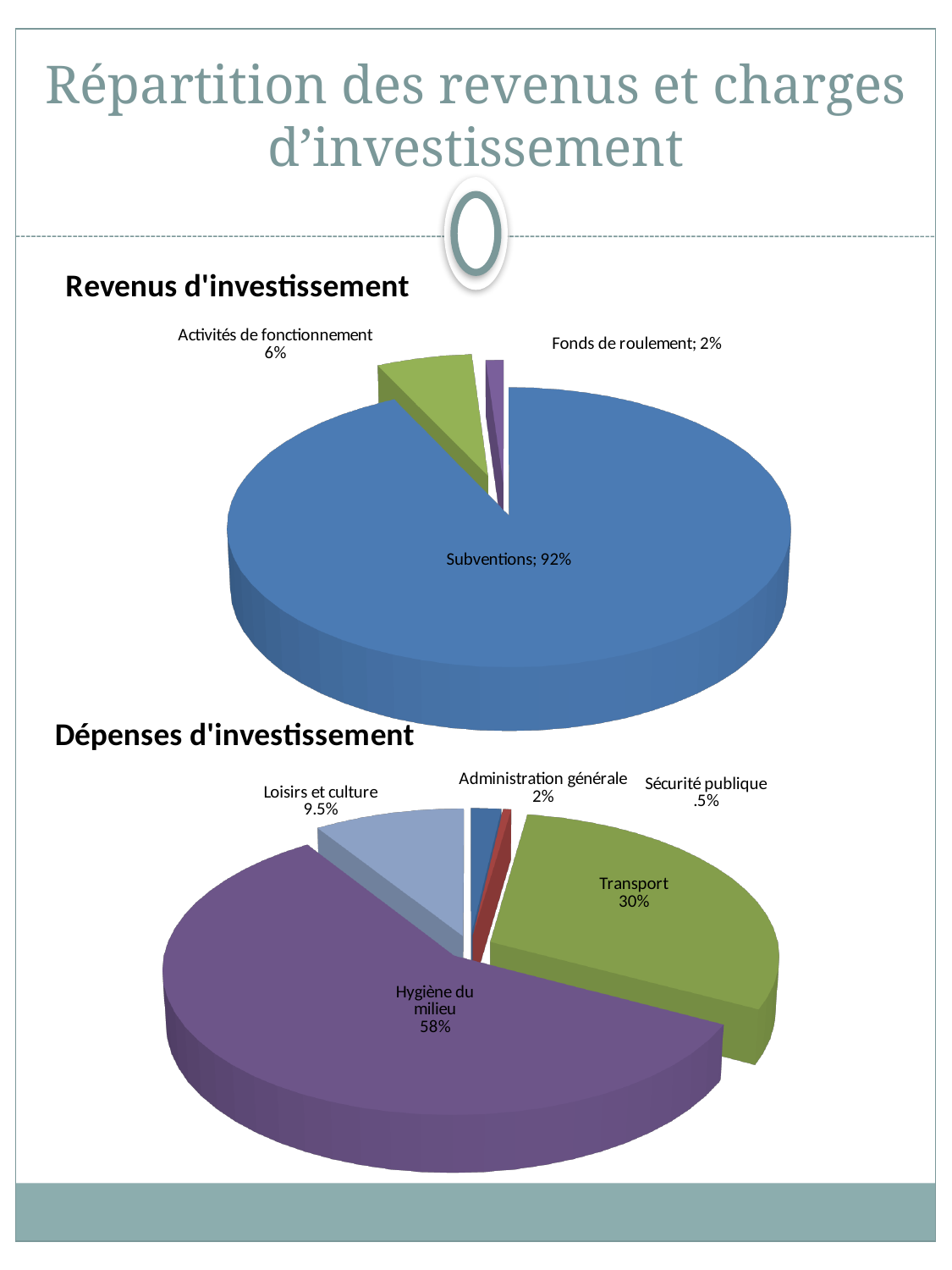
In the 'Revenus d'investissement' chart, what share does Subventions have? 92% In the 'Dépenses d'investissement' chart, what share does Loisirs et culture have? 9.5% In the 'Revenus d'investissement' chart, what is the difference between the Subventions share and the Activités de fonctionnement share? 86% In the 'Dépenses d'investissement' chart, which category has the smallest share? Sécurité publique In the 'Dépenses d'investissement' chart, what share does Transport have? 30% In the 'Revenus d'investissement' chart, how many slices does the pie have? 3 In the 'Dépenses d'investissement' chart, how many slices does the pie have? 5 What type of chart is the 'Revenus d'investissement' chart? Pie chart In the 'Dépenses d'investissement' chart, which is larger, Transport or Loisirs et culture? Transport In the 'Dépenses d'investissement' chart, which category has the largest share? Hygiène du milieu In the 'Revenus d'investissement' chart, which category has the smallest share? Fonds de roulement In the 'Revenus d'investissement' chart, what share does Activités de fonctionnement have? 6%